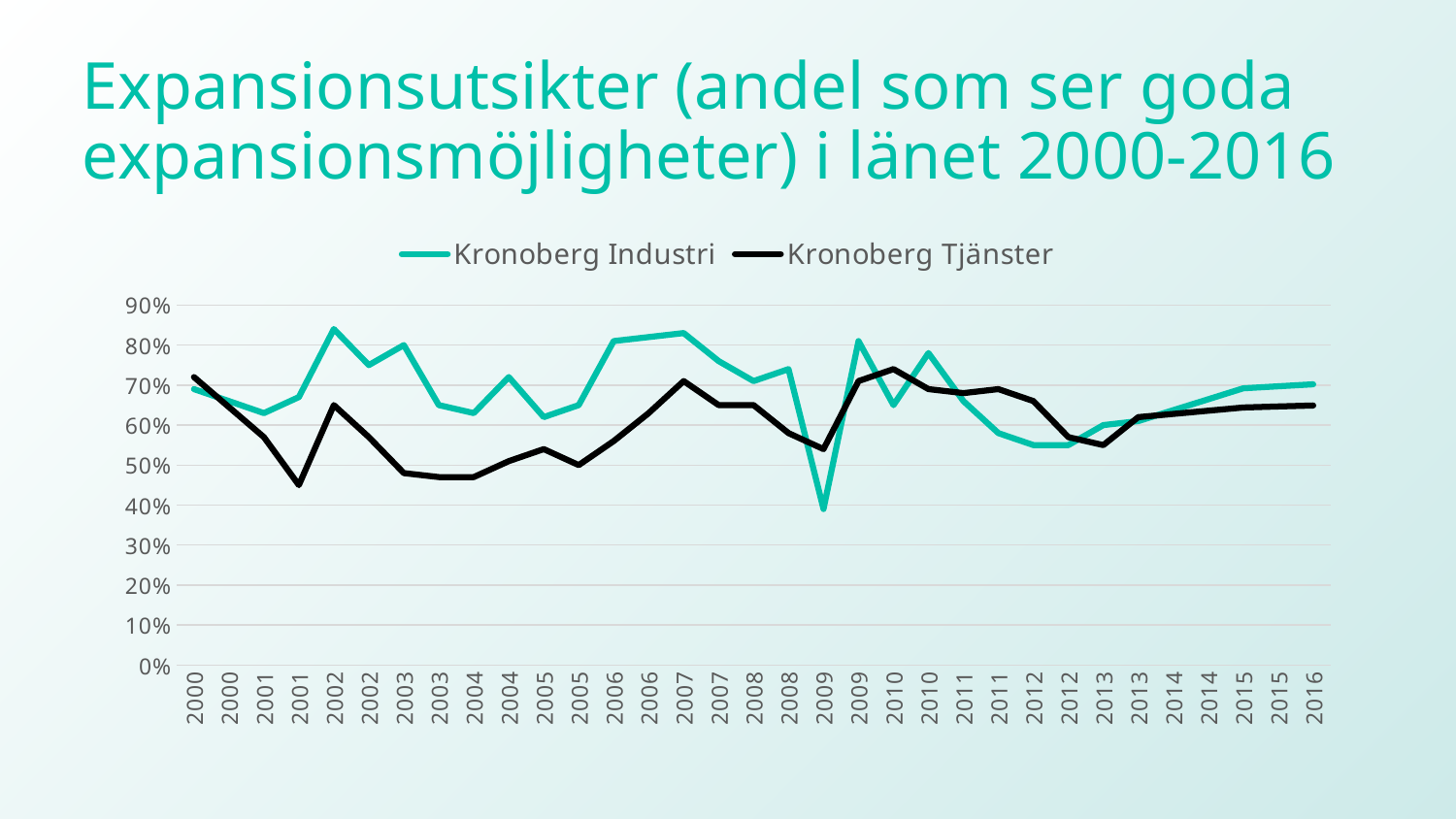
Is the value for Kronoberg Tjänster at 2016 greater or less than 60%? greater What colour is the Kronoberg Tjänster line? black Which series reaches the highest value anywhere on the chart? Kronoberg Industri How many data points are plotted along the x axis for each series? 33 Which two series are listed in the legend? Kronoberg Industri and Kronoberg Tjänster Which series has the lowest point anywhere on the chart? Kronoberg Industri Is the value for Kronoberg Industri at the first 2002 point greater or less than 80%? greater Is the value for Kronoberg Industri at the first 2009 point greater or less than 50%? less At the first 2004 point, which series has the higher value, Kronoberg Industri or Kronoberg Tjänster? Kronoberg Industri What kind of chart is shown on the slide? line chart How many series does the legend list? 2